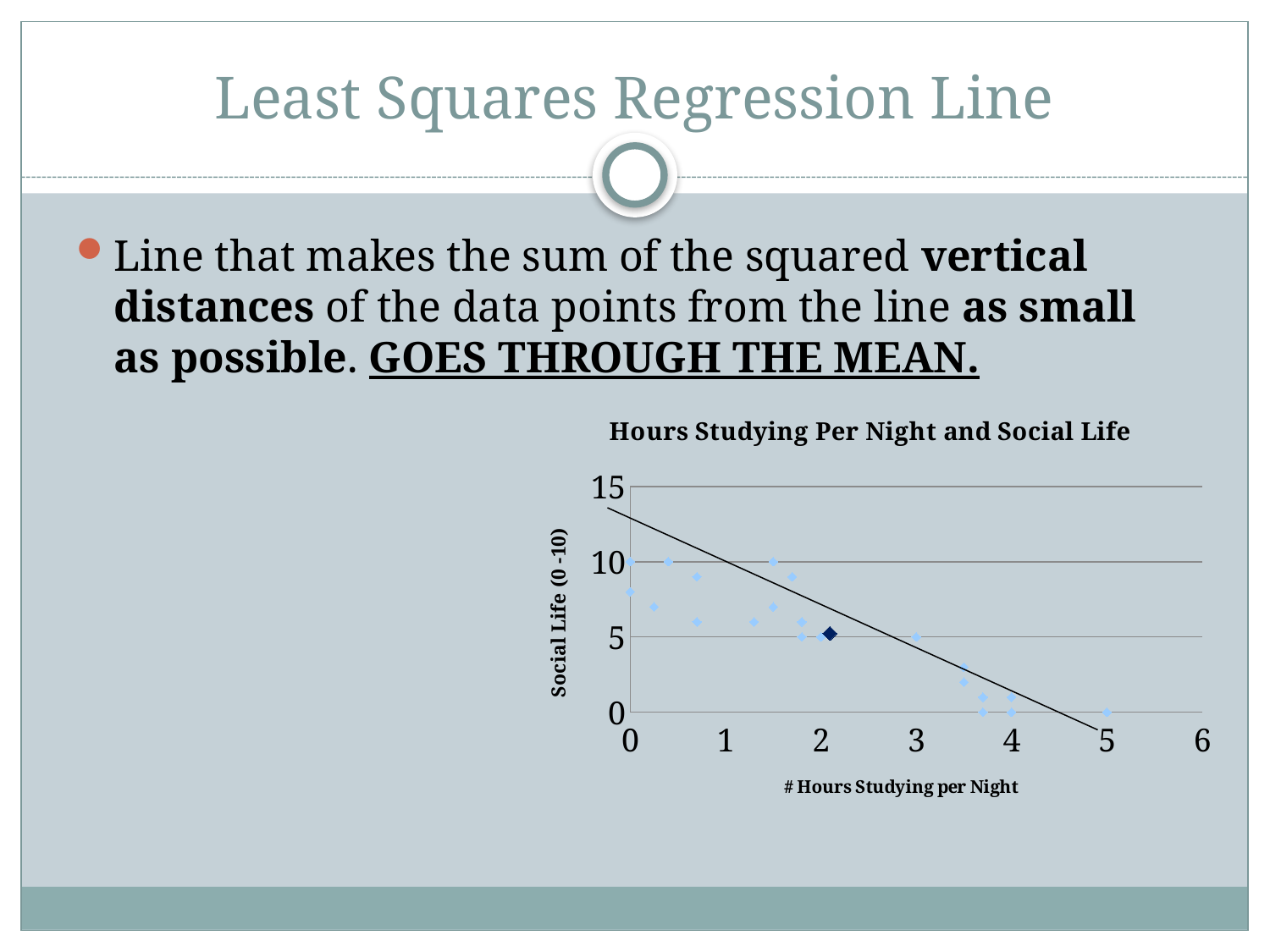
As the number of hours studying per night increases, does social life rise or fall? Fall What is the label of the x axis? # Hours Studying per Night Is the y-intercept of the regression line greater or less than 10? greater What kind of chart is shown on the slide? Scatter plot with a fitted line What is the title of the chart? Hours Studying Per Night and Social Life What is the highest value shown on the y axis? 15 What is the highest value shown on the x axis? 6 Is the social life value for the point at 5 hours studying greater or less than 5? less Is the highest social life value plotted greater or less than 15? less Does the regression line slope upward or downward from left to right? Downward